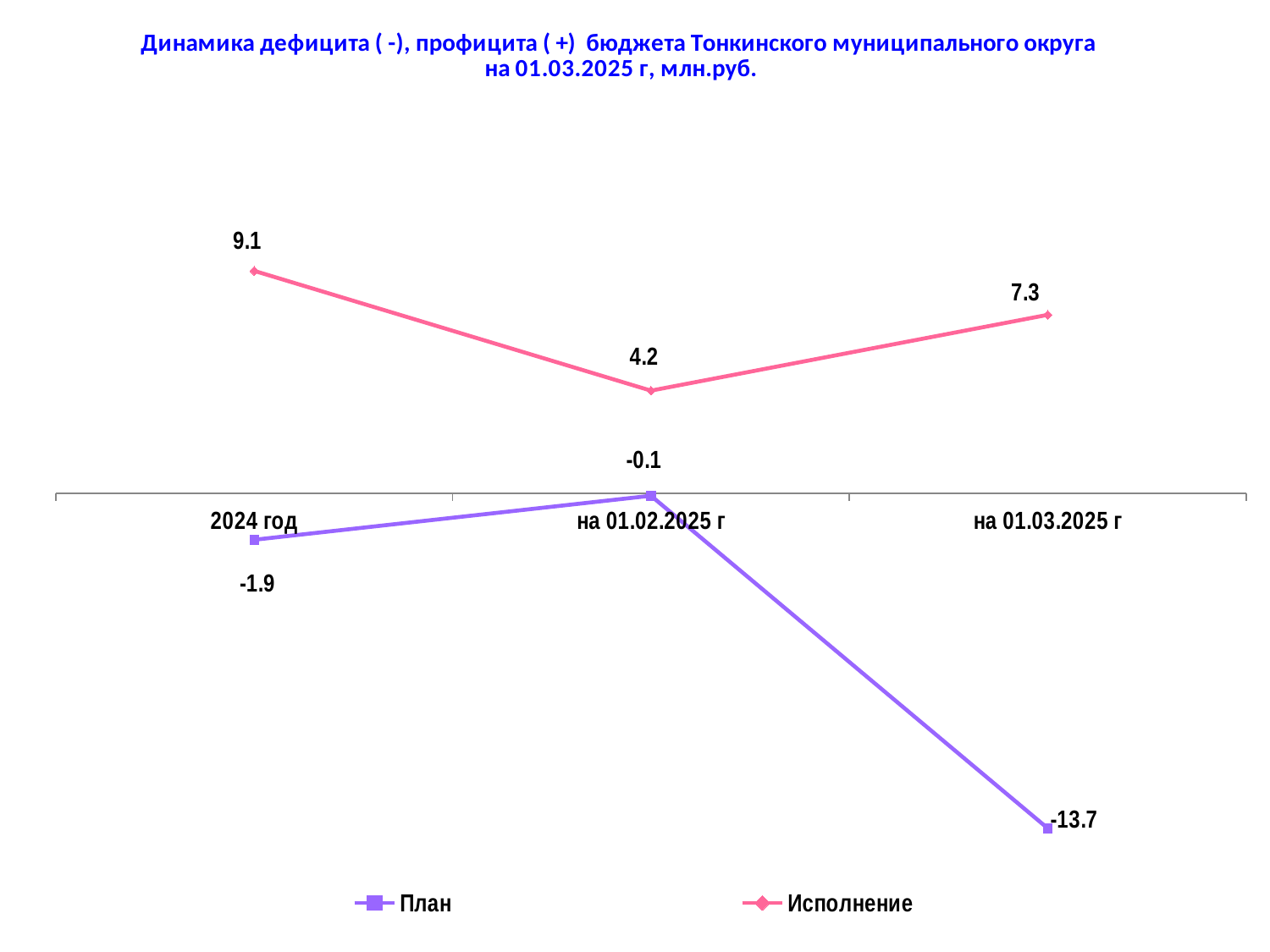
How many series does the legend list? 2 How many categories are shown on the x axis? 3 What is the value of the Исполнение series at на 01.02.2025 г? 4.2 At which category does the Исполнение series reach its highest value? 2024 год Does the План series rise or fall from на 01.02.2025 г to на 01.03.2025 г? Fall What is the value of the План series for 2024 год? -1.9 What is the value of the Исполнение series at на 01.03.2025 г? 7.3 Which series has the larger value at на 01.02.2025 г, План or Исполнение? Исполнение What is the difference between the Исполнение value and the План value at на 01.03.2025 г? 21 What kind of chart is shown on the slide? Line chart At which category does the План series reach its lowest value? на 01.03.2025 г What is the value of the План series at на 01.02.2025 г? -0.1